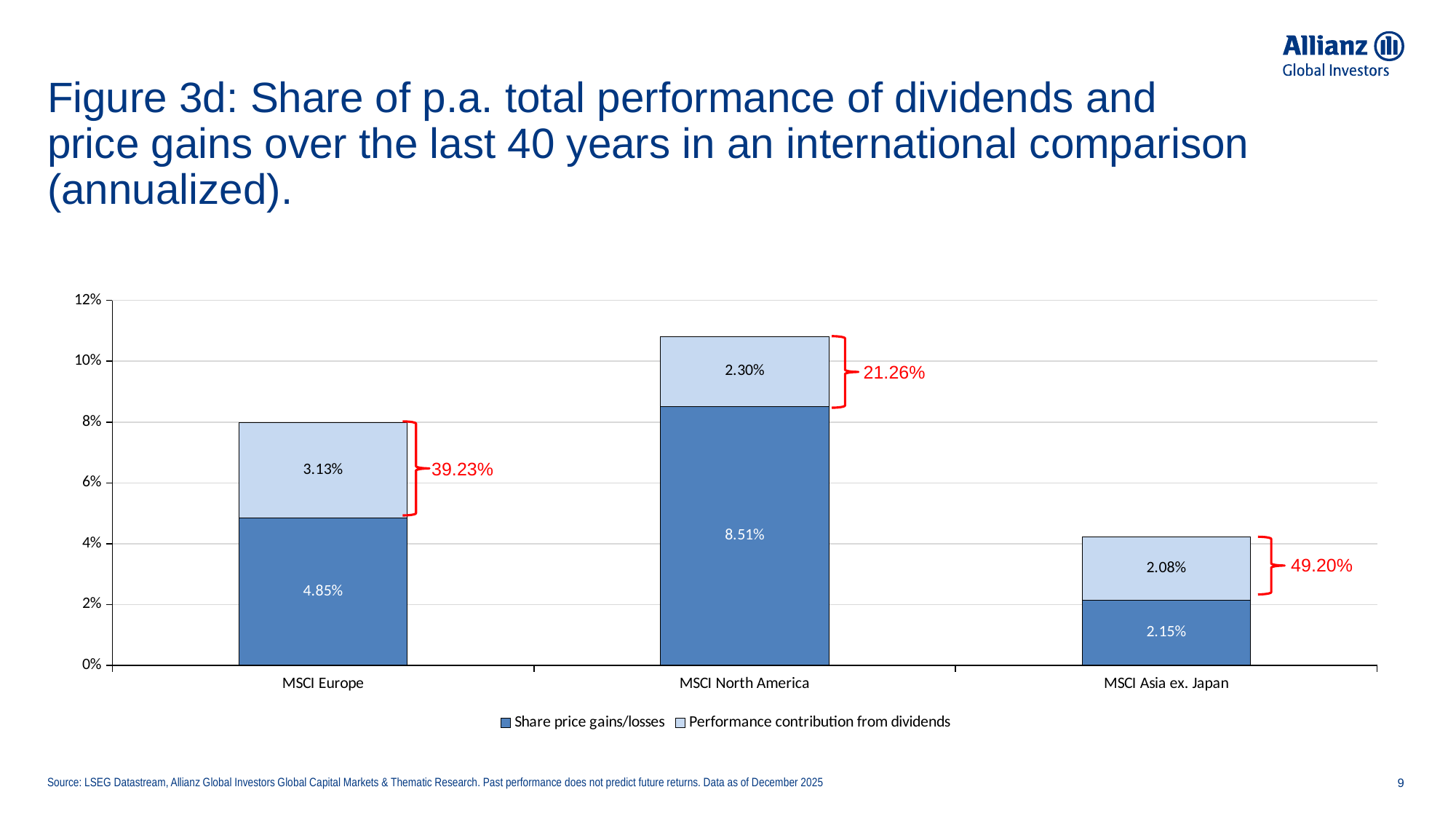
Which region has the highest share price gains/losses value? MSCI North America What is the total of the stacked bar for MSCI Asia ex. Japan? 4.23% What is the total of the stacked bar for MSCI North America? 10.81% What is the share price gains/losses value for MSCI Asia ex. Japan? 2.15% What is the difference between the share price gains/losses of MSCI North America and MSCI Europe? 3.66% Which region has the lowest performance contribution from dividends? MSCI Asia ex. Japan How many series does the legend list? 2 Which is larger: the performance contribution from dividends for MSCI Europe or for MSCI North America? MSCI Europe How many regions are shown on the x axis? 3 What is the share price gains/losses value for MSCI North America? 8.51% What is the performance contribution from dividends for MSCI Europe? 3.13% What percentage is shown in red next to the MSCI Asia ex. Japan bar? 49.20%